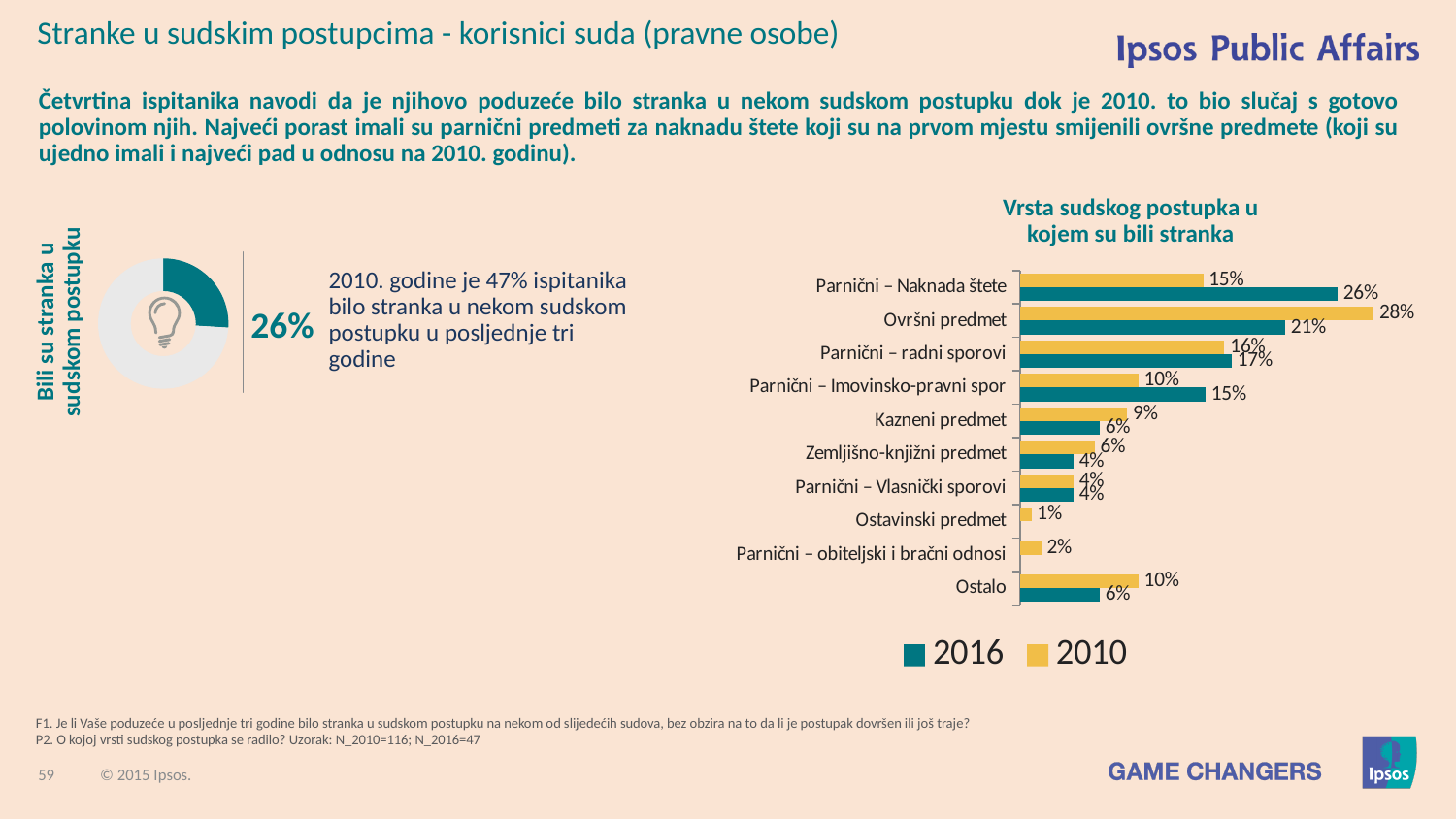
What kind of chart is 'Vrsta sudskog postupka u kojem su bili stranka'? bar chart In the bar chart 'Vrsta sudskog postupka u kojem su bili stranka', how many series does the legend list? 2 In the bar chart 'Vrsta sudskog postupka u kojem su bili stranka', which year does the yellow colour represent? 2010 In the bar chart 'Vrsta sudskog postupka u kojem su bili stranka', what is the 2016 value for 'Parnični – Naknada štete'? 26% In the bar chart 'Vrsta sudskog postupka u kojem su bili stranka', what is the 2016 value for 'Parnični – Imovinsko-pravni spor'? 15% In the bar chart 'Vrsta sudskog postupka u kojem su bili stranka', what is the difference between the 2010 and 2016 values for 'Ovršni predmet'? 7 percentage points What value is shown in the donut chart on the left of the slide? 26% In the bar chart 'Vrsta sudskog postupka u kojem su bili stranka', how many categories are listed? 10 In the bar chart 'Vrsta sudskog postupka u kojem su bili stranka', which category has the lowest 2010 value? Ostavinski predmet In the bar chart 'Vrsta sudskog postupka u kojem su bili stranka', is the 2016 value for 'Kazneni predmet' larger or smaller than its 2010 value? smaller In the bar chart 'Vrsta sudskog postupka u kojem su bili stranka', which category has the highest 2016 value? Parnični – Naknada štete In the bar chart 'Vrsta sudskog postupka u kojem su bili stranka', what is the 2010 value for 'Ovršni predmet'? 28%